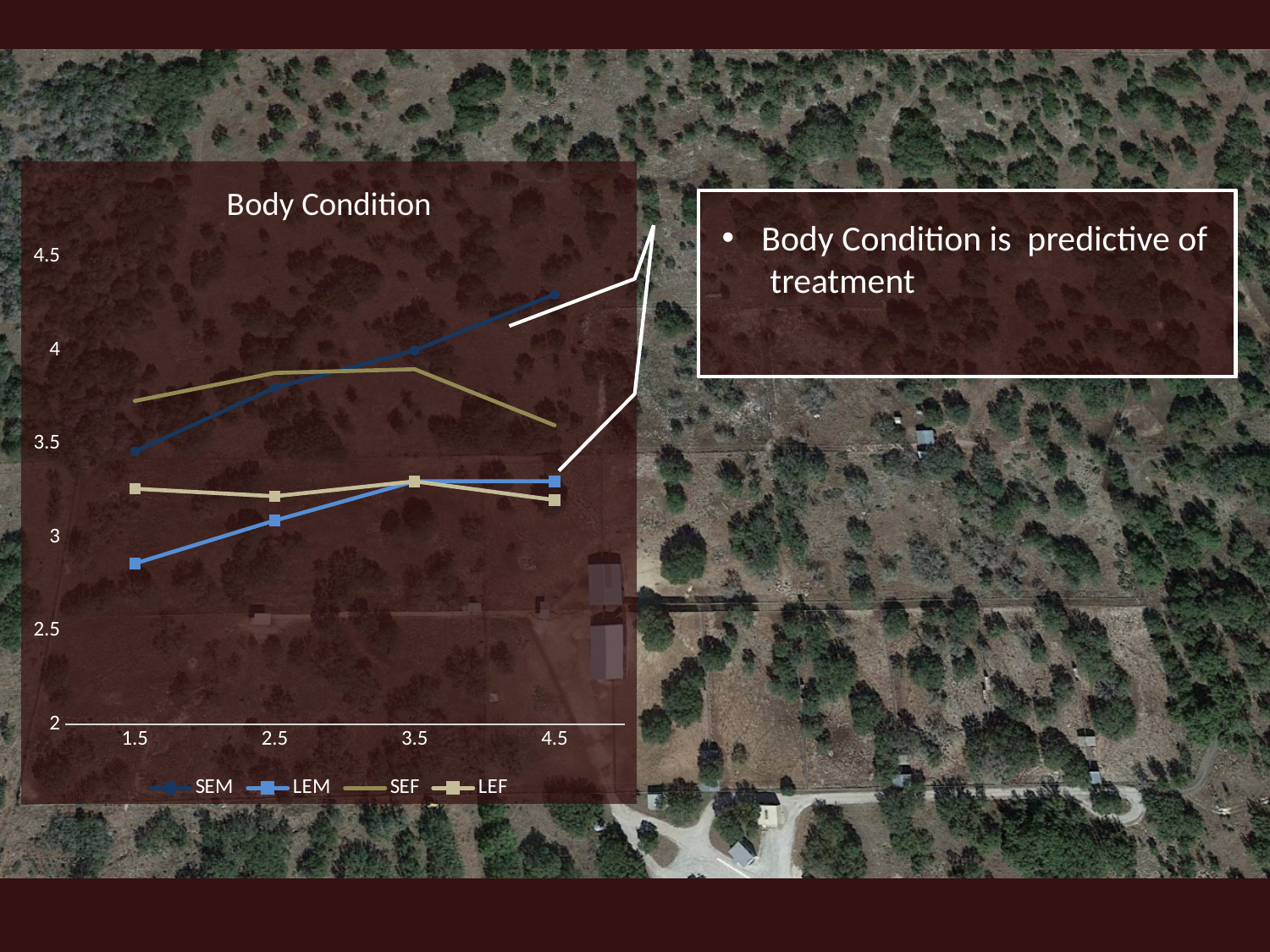
Is the value for SEF at 1.5 greater or less than 3.5? greater What is the title of the chart on the slide? Body Condition Is the value for SEM at 4.5 greater or less than 4? greater Which series are listed in the legend of the Body Condition chart? SEM, LEM, SEF, LEF Which series has the lowest value at 1.5? LEM What kind of chart is the Body Condition chart? line chart Does the SEM series rise or fall from 1.5 to 4.5 along the x axis? rise How many series does the legend of the Body Condition chart list? 4 Which series has the highest value at 4.5? SEM Is the value for LEM at 1.5 greater or less than 3? less How many points are shown along the x axis of the Body Condition chart? 4 At 1.5, which is larger, SEM or LEM? SEM